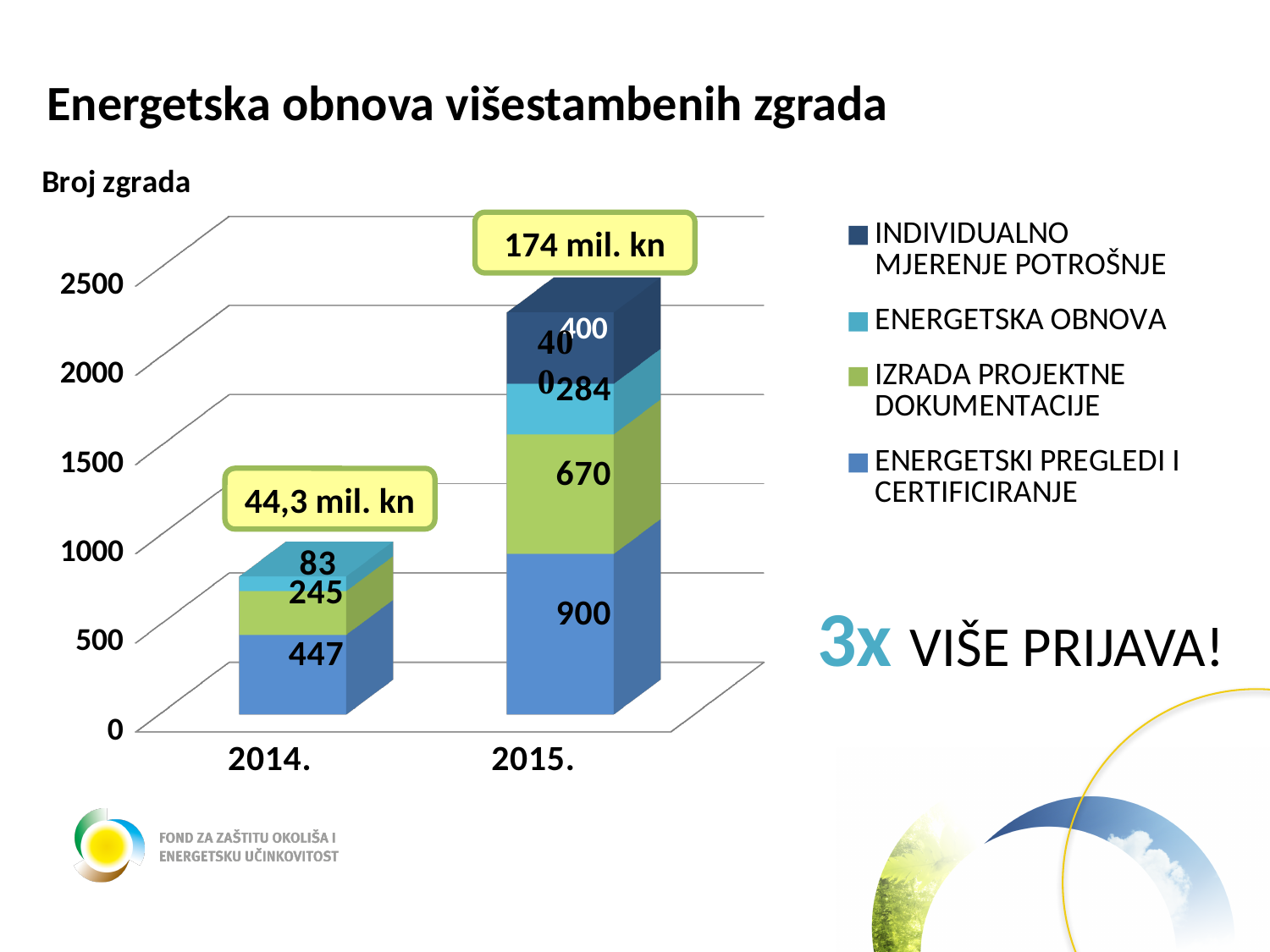
What is the total of the stacked bar for 2014.? 775 Which year has the larger value for IZRADA PROJEKTNE DOKUMENTACIJE, 2014. or 2015.? 2015. What is the value for ENERGETSKA OBNOVA in 2014.? 83 What amount is shown in the callout above the 2015. bar? 174 mil. kn What is the value for ENERGETSKI PREGLEDI I CERTIFICIRANJE in 2014.? 447 How many series does the legend list? 4 What kind of chart is shown on the slide? Stacked bar chart What is the difference between the ENERGETSKI PREGLEDI I CERTIFICIRANJE values for 2015. and 2014.? 453 What is the value for INDIVIDUALNO MJERENJE POTROŠNJE in 2015.? 400 How many years are shown on the x axis? 2 What is the value for ENERGETSKA OBNOVA in 2015.? 284 What is the value for IZRADA PROJEKTNE DOKUMENTACIJE in 2015.? 670